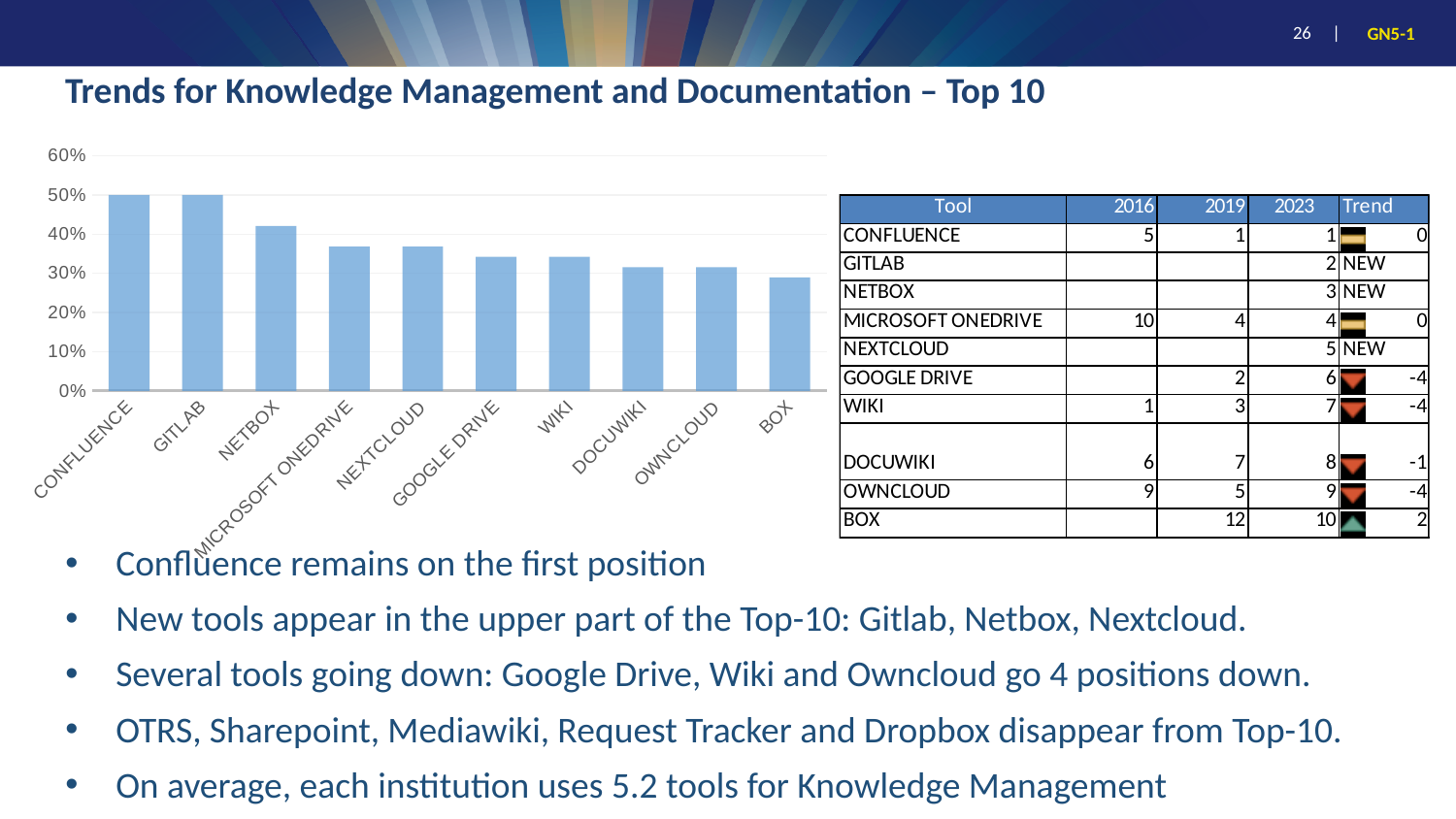
What is the value for GITLAB in the chart? 50% Is the value for MICROSOFT ONEDRIVE greater or less than 40%? less What is the value for CONFLUENCE in the chart? 50% Which has a larger value in the chart, NETBOX or BOX? NETBOX How many tools are shown as bars in the chart? 10 Is the value for BOX greater or less than 20%? greater Is the value for NETBOX greater or less than 50%? less What kind of chart is shown on the slide? bar chart Do the bar values generally rise or fall from left to right along the x axis? fall Which has a larger value in the chart, CONFLUENCE or WIKI? CONFLUENCE What is the title of the slide containing the chart? Trends for Knowledge Management and Documentation – Top 10